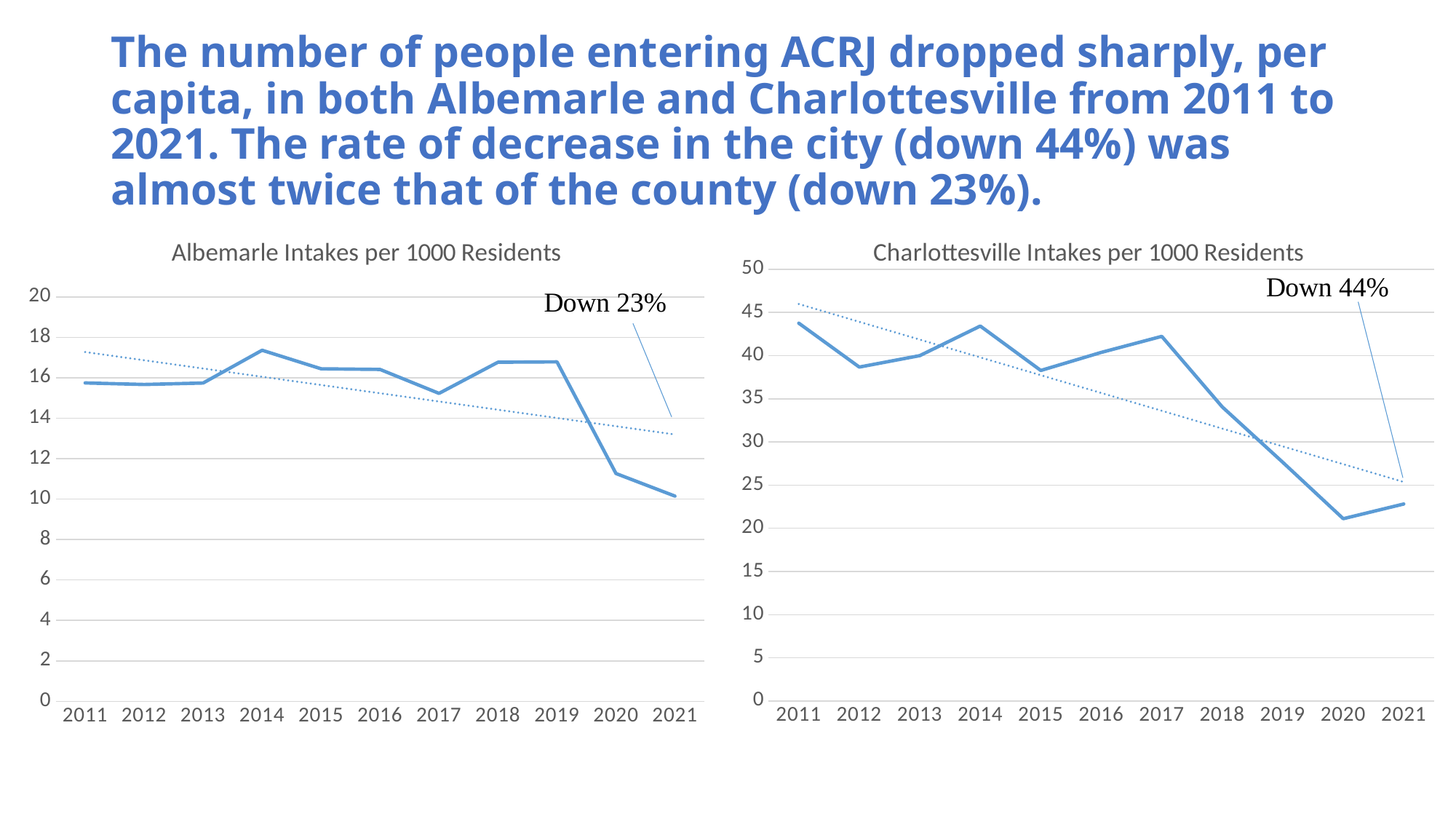
In the Albemarle Intakes per 1000 Residents chart, is the value for 2014 greater or less than 16? greater What percentage decrease is annotated on the Albemarle Intakes per 1000 Residents chart? Down 23% In the Albemarle Intakes per 1000 Residents chart, is the value for 2021 greater or less than 12? less In the Albemarle Intakes per 1000 Residents chart, which is larger, the value for 2019 or the value for 2020? 2019 What kind of chart is the Albemarle Intakes per 1000 Residents chart? line chart In the Charlottesville Intakes per 1000 Residents chart, which year has the lowest value? 2020 In the Charlottesville Intakes per 1000 Residents chart, do the values overall rise or fall from 2011 to 2021? fall In the Charlottesville Intakes per 1000 Residents chart, is the value for 2020 greater or less than 25? less In the Albemarle Intakes per 1000 Residents chart, which year has the lowest value? 2021 In the Charlottesville Intakes per 1000 Residents chart, which is larger, the value for 2017 or the value for 2018? 2017 How many years are shown on the x axis of the Charlottesville Intakes per 1000 Residents chart? 11